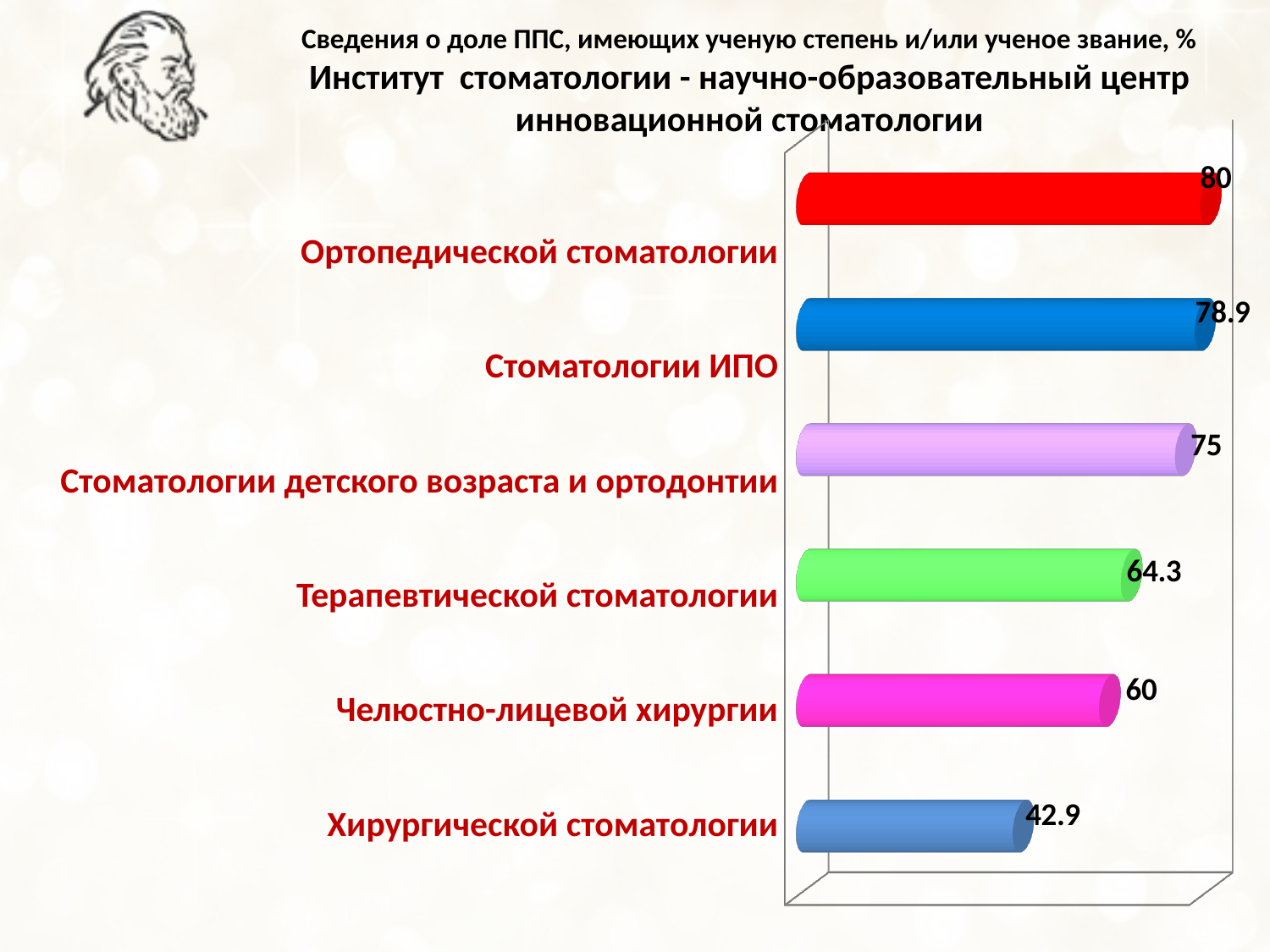
What is the value for Ортопедической стоматологии? 80 What is the difference between the values for Челюстно-лицевой хирургии and Хирургической стоматологии? 17.1 What kind of chart is shown on the slide? Bar chart Which is larger, the value for Терапевтической стоматологии or the value for Челюстно-лицевой хирургии? Терапевтической стоматологии What is the value for Стоматологии детского возраста и ортодонтии? 75 What is the value for Стоматологии ИПО? 78.9 Which category has the lowest value? Хирургической стоматологии How many categories are shown in the chart? 6 What is the value for Терапевтической стоматологии? 64.3 What is the value for Хирургической стоматологии? 42.9 Which category has the highest value? Ортопедической стоматологии What colour is the bar for Челюстно-лицевой хирургии? Magenta (pink)